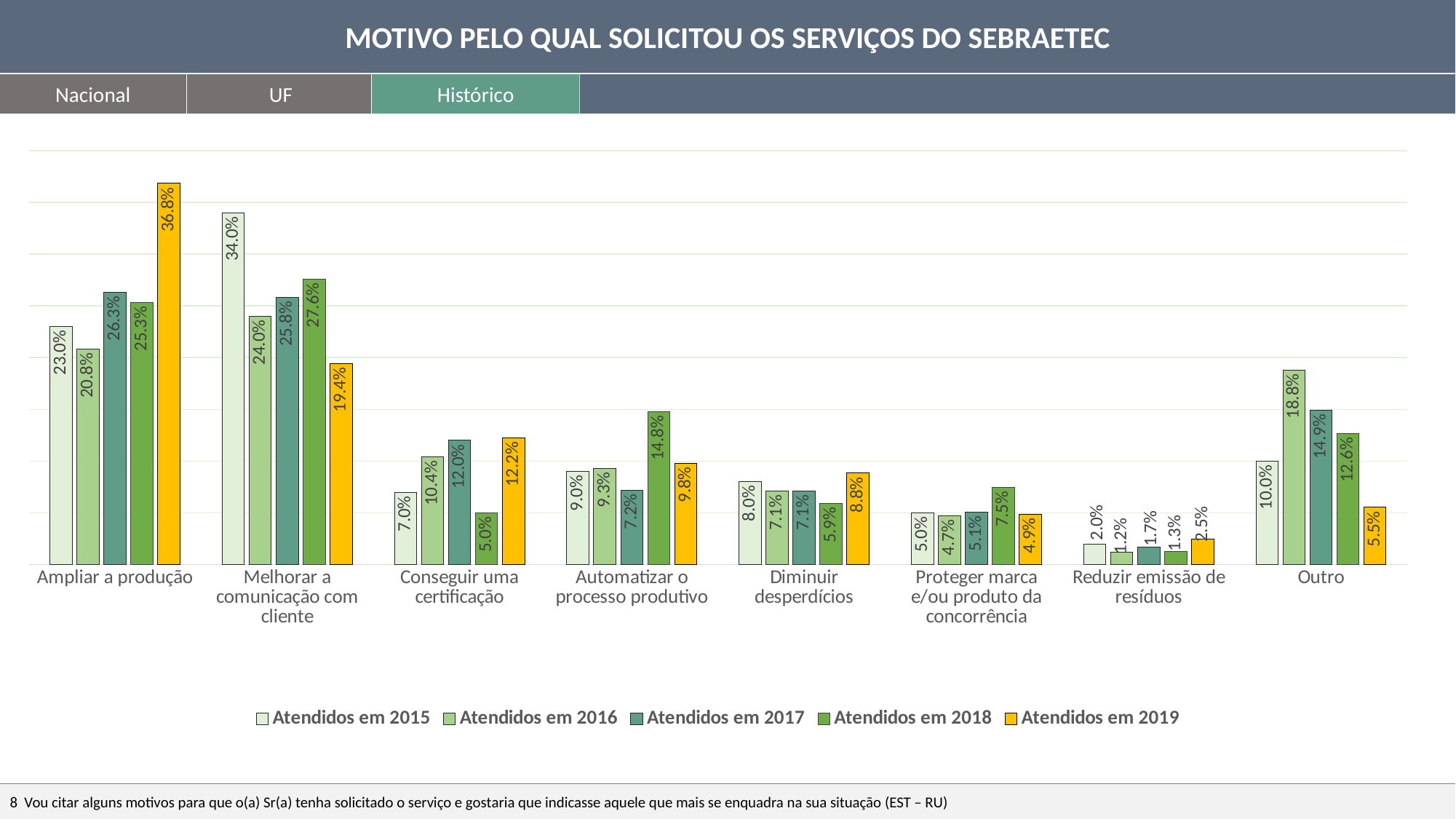
Which category has the highest value in the 'Atendidos em 2018' series? Melhorar a comunicação com cliente What is the value for 'Melhorar a comunicação com cliente' in the 'Atendidos em 2015' series? 34.0% What is the value for 'Outro' in the 'Atendidos em 2016' series? 18.8% What kind of chart is shown on the slide? Bar chart What is the title of the chart? MOTIVO PELO QUAL SOLICITOU OS SERVIÇOS DO SEBRAETEC Which category has the lowest value in the 'Atendidos em 2017' series? Reduzir emissão de resíduos What is the value for 'Ampliar a produção' in the 'Atendidos em 2019' series? 36.8% Which is larger for 'Conseguir uma certificação': the 'Atendidos em 2017' value or the 'Atendidos em 2018' value? Atendidos em 2017 How many categories are shown on the x axis? 8 How many series does the legend list? 5 What is the value for 'Automatizar o processo produtivo' in the 'Atendidos em 2018' series? 14.8% What is the difference between the 'Atendidos em 2019' and 'Atendidos em 2015' values for 'Ampliar a produção'? 13.8%